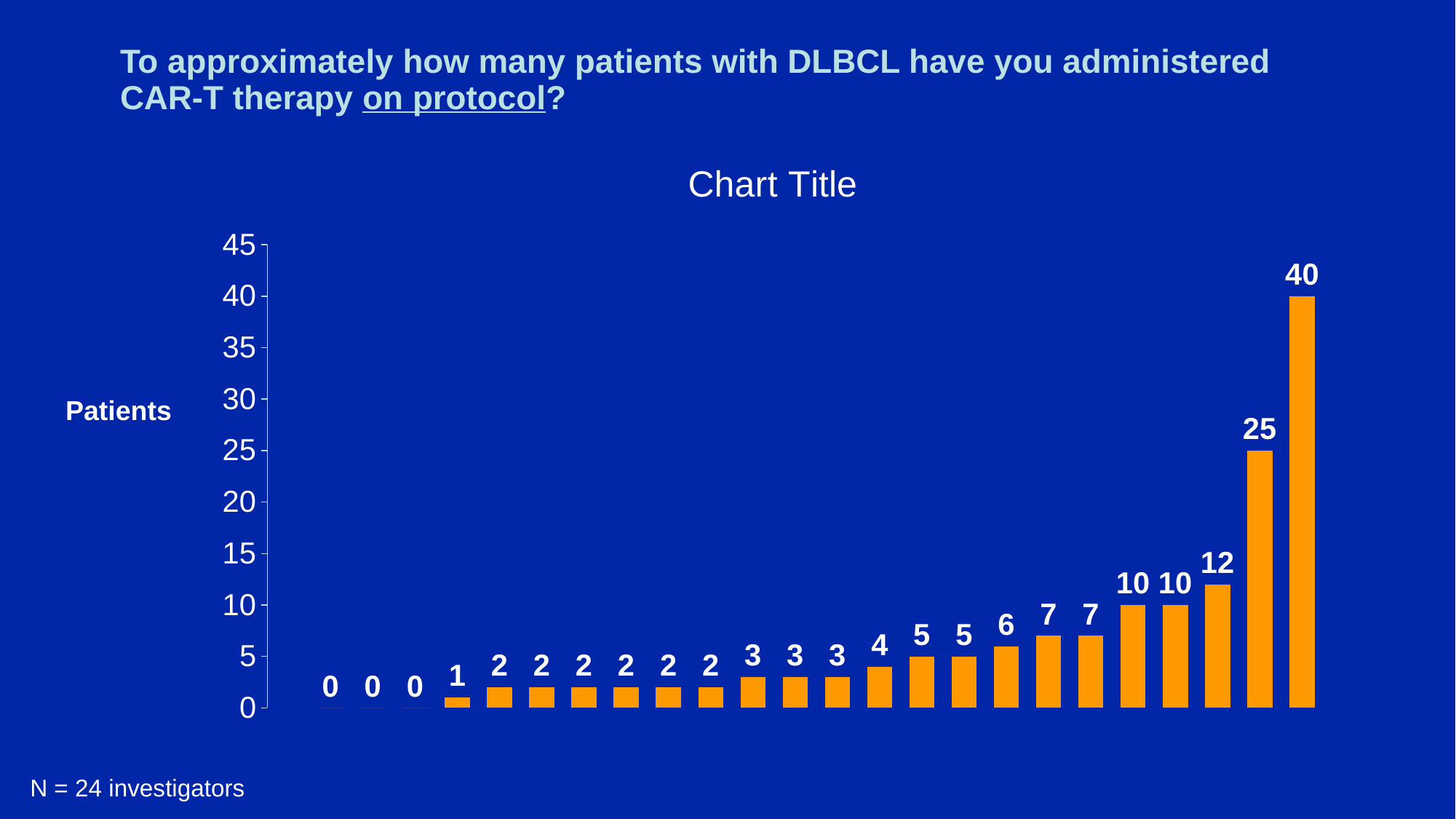
What is the lowest value shown in the chart? 0 What is the highest value shown in the chart? 40 What type of chart is shown on the slide? bar chart Is the value of the rightmost bar greater or less than 35? greater How many bars have a value of 0? 3 Do the bar values rise or fall from left to right across the chart? rise How many bars have a value of 2? 6 How many bars (investigators) are plotted in the chart? 24 What is the label on the vertical axis of the chart? Patients What is the value of the second bar from the right? 25 What is the difference between the tallest bar and the second-tallest bar? 15 What is the value of the third bar from the right? 12